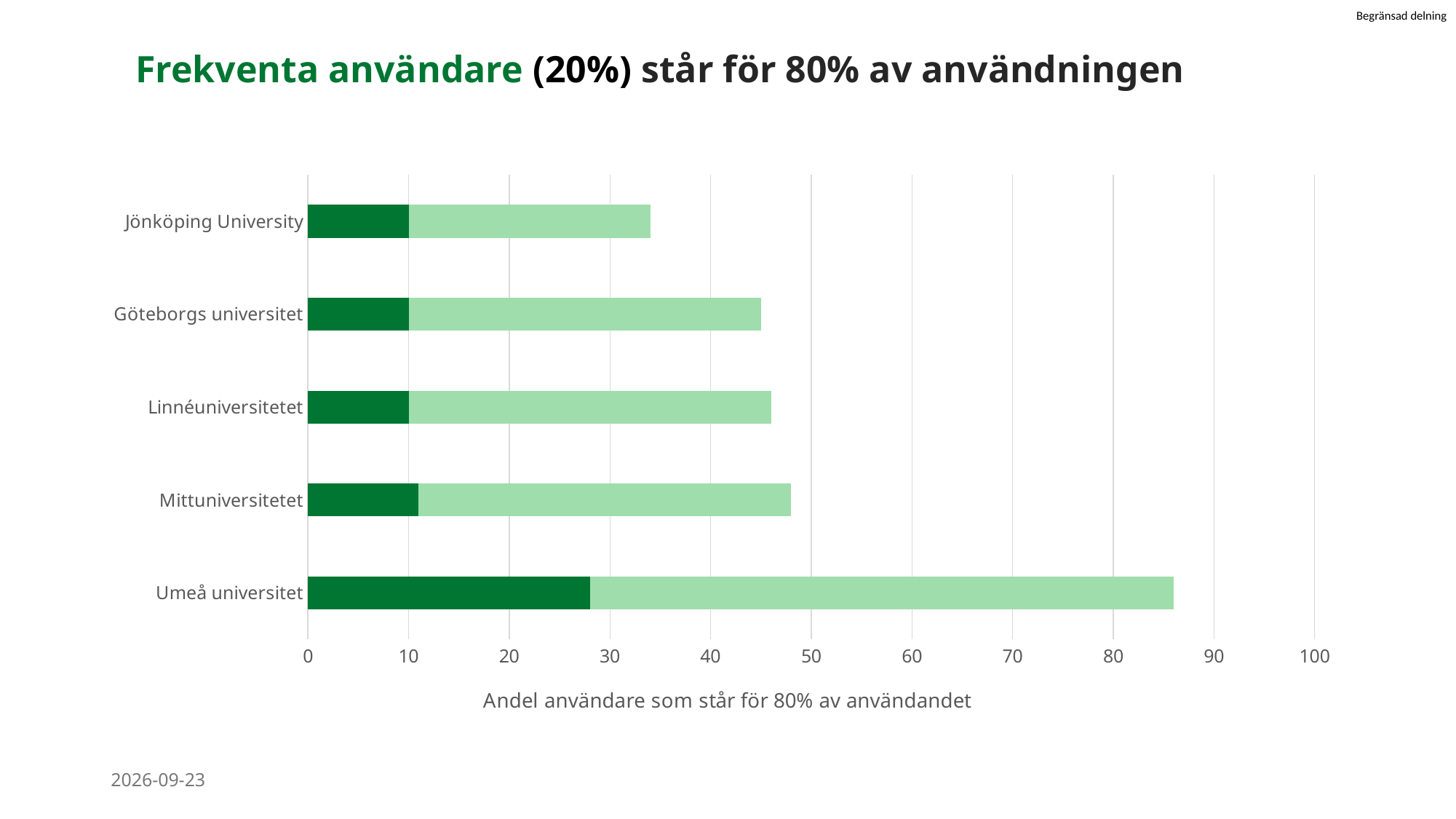
What is the maximum value shown on the horizontal axis? 100 What kind of chart is shown on the slide? bar chart Which university has the longest bar? Umeå universitet Which university has the shortest bar? Jönköping University Is the total bar length for Jönköping University greater or less than 40? less What is the title of the horizontal axis? Andel användare som står för 80% av användandet Is the total bar length for Umeå universitet greater or less than 80? greater Is the total bar length for Mittuniversitetet greater or less than 50? less Which has a longer bar, Umeå universitet or Göteborgs universitet? Umeå universitet How many universities are shown on the chart? 5 Which has a longer bar, Mittuniversitetet or Jönköping University? Mittuniversitetet